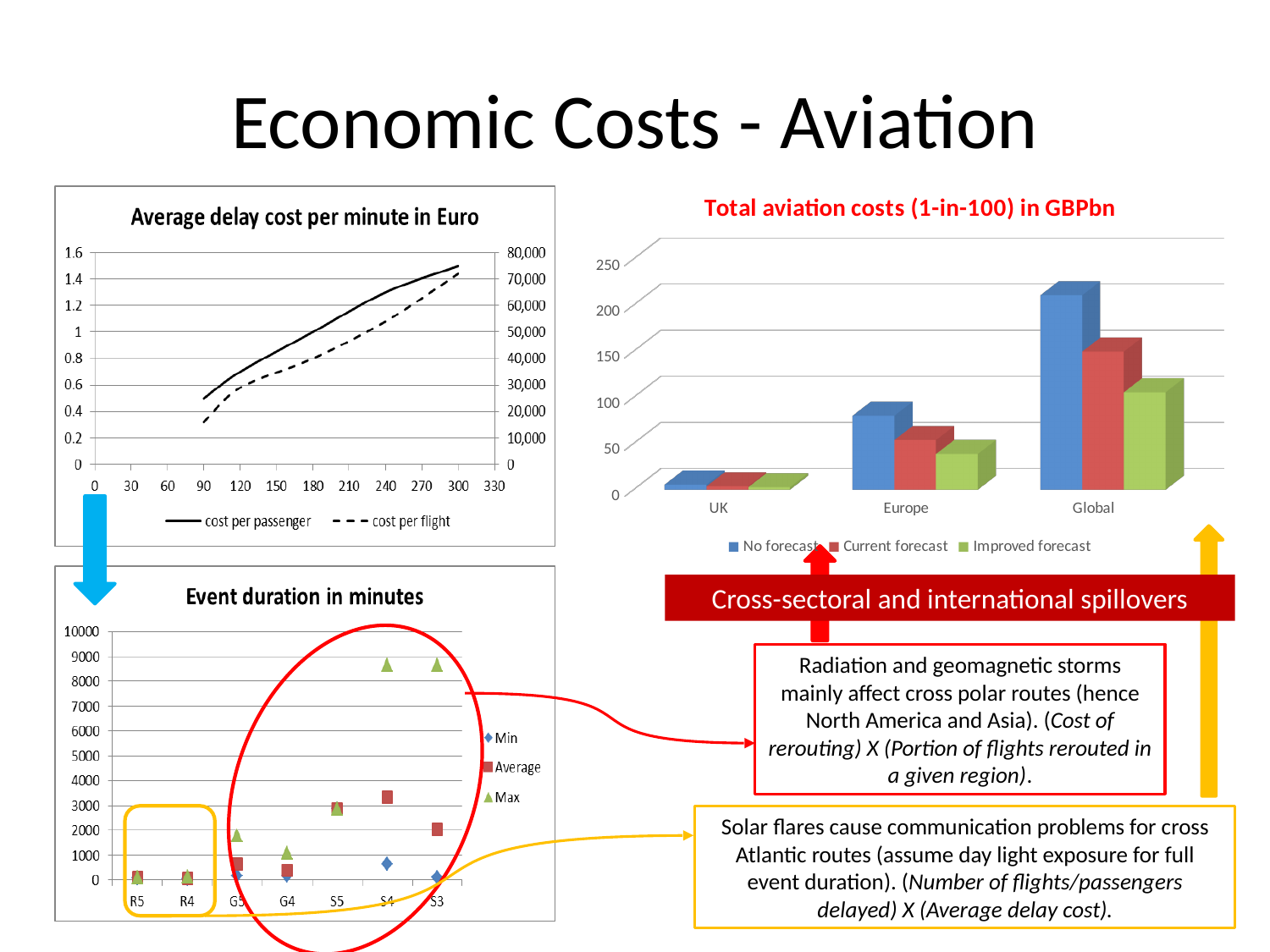
In the 'Total aviation costs (1-in-100) in GBPbn' chart, how many series does the legend list? 3 In the 'Total aviation costs (1-in-100) in GBPbn' chart, is the No forecast value for Global greater or less than 150? greater In the 'Event duration in minutes' chart, how many categories are shown on the x axis? 7 In the 'Total aviation costs (1-in-100) in GBPbn' chart, which region has the highest No forecast value? Global In the 'Total aviation costs (1-in-100) in GBPbn' chart, which region has the lowest values across all series? UK In the 'Total aviation costs (1-in-100) in GBPbn' chart, is the No forecast value for Europe greater or less than 100? less In the 'Total aviation costs (1-in-100) in GBPbn' chart, how many regions are shown on the x axis? 3 What kind of chart is 'Average delay cost per minute in Euro'? line chart In the 'Event duration in minutes' chart, is the Max value for S4 greater or less than 8000? greater In the 'Average delay cost per minute in Euro' chart, how many series does the legend list? 2 In the 'Average delay cost per minute in Euro' chart, do the values rise or fall as the x axis increases? rise In the 'Total aviation costs (1-in-100) in GBPbn' chart, for Europe, which is larger: No forecast or Improved forecast? No forecast